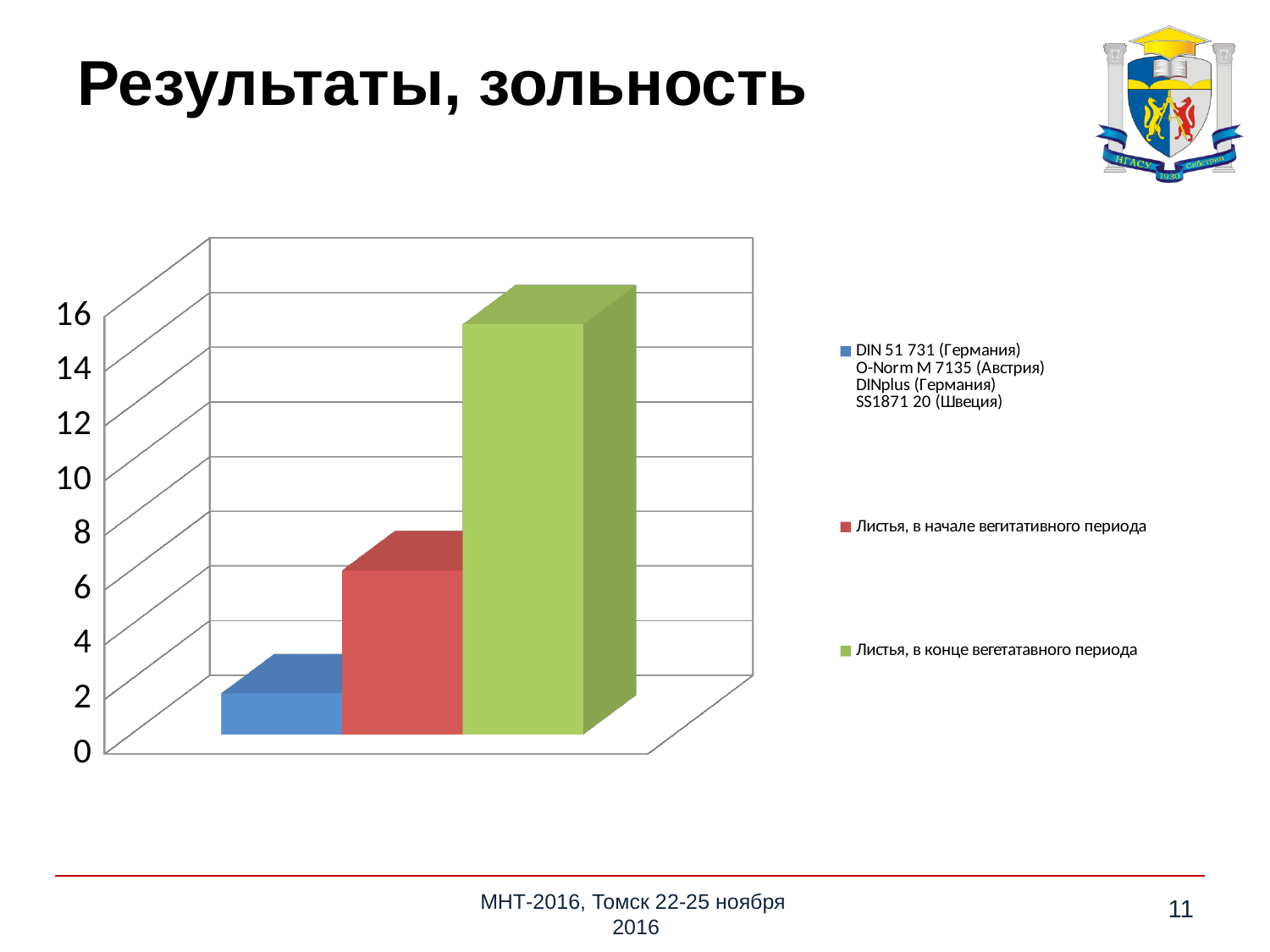
Is the value for 'Листья, в начале вегитативного периода' greater or less than 10? less What is the title of the slide containing the chart? Результаты, зольность Is the value for the DIN 51 731 / O-Norm M 7135 / DINplus / SS1871 20 standards greater or less than 4? less Is the value for 'Листья, в конце вегетатавного периода' greater or less than 12? greater How many bars are plotted in the chart? 3 Which series has the lowest bar? DIN 51 731 (Германия) O-Norm M 7135 (Австрия) DINplus (Германия) SS1871 20 (Швеция) Which series has the highest bar? Листья, в конце вегетатавного периода How many series does the legend list? 3 What kind of chart is shown on the slide? bar chart Which is larger: the value for 'Листья, в начале вегитативного периода' or the value for the DIN 51 731 / O-Norm M 7135 / DINplus / SS1871 20 standards? Листья, в начале вегитативного периода What colour represents 'Листья, в конце вегетатавного периода' in the chart? green